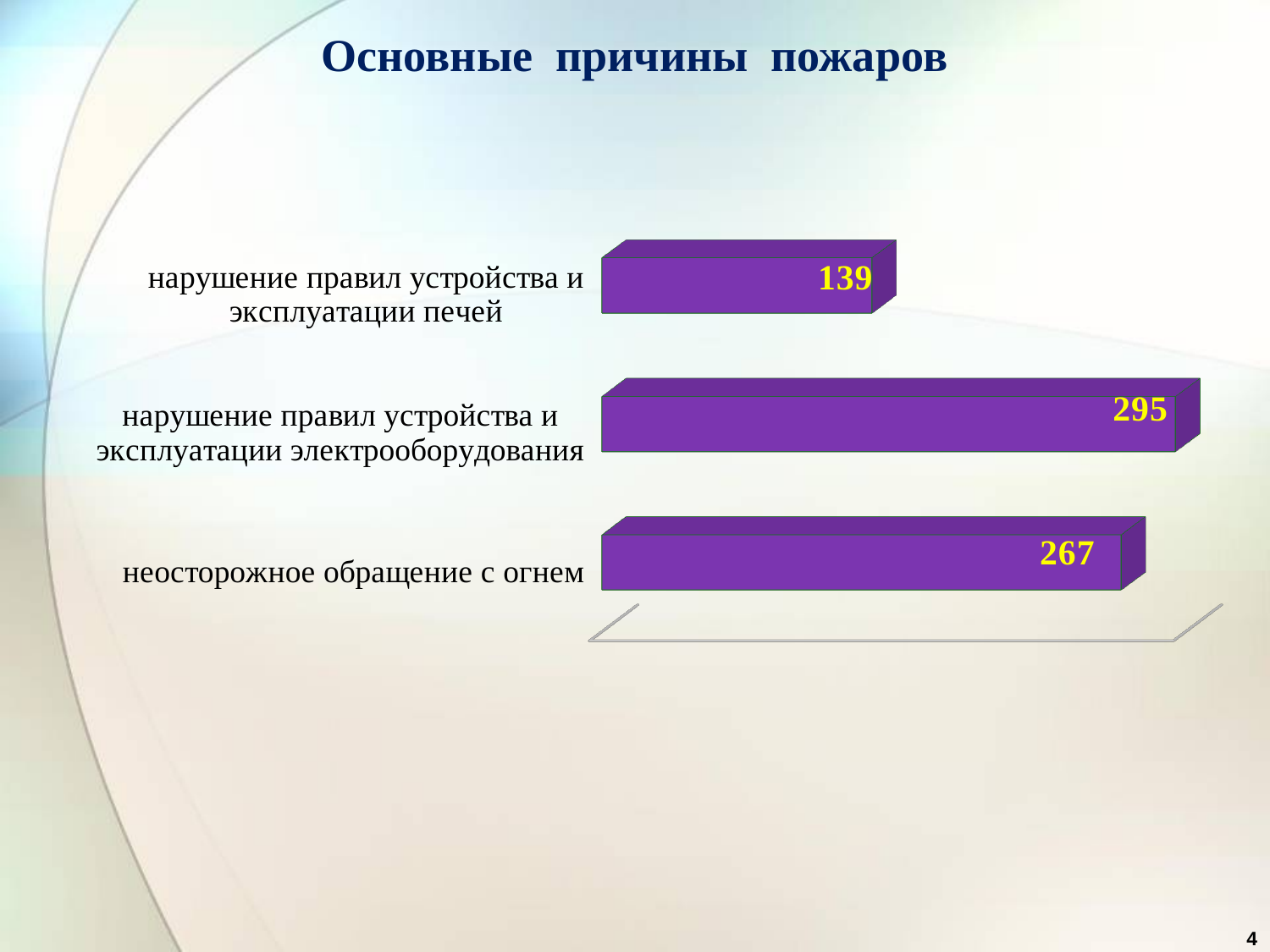
What is the value for "нарушение правил устройства и эксплуатации электрооборудования"? 295 How many categories are shown in the chart? 3 What is the value for "нарушение правил устройства и эксплуатации печей"? 139 What is the difference between the values for "неосторожное обращение с огнем" and "нарушение правил устройства и эксплуатации печей"? 128 What is the value for "неосторожное обращение с огнем"? 267 Which is larger: the value for "неосторожное обращение с огнем" or for "нарушение правил устройства и эксплуатации печей"? неосторожное обращение с огнем What is the title of the slide? Основные причины пожаров What is the difference between the values for "нарушение правил устройства и эксплуатации электрооборудования" and "неосторожное обращение с огнем"? 28 Which category has the highest value? нарушение правил устройства и эксплуатации электрооборудования What kind of chart is shown on the slide? bar chart What colour are the bars in the chart? purple Which category has the lowest value? нарушение правил устройства и эксплуатации печей